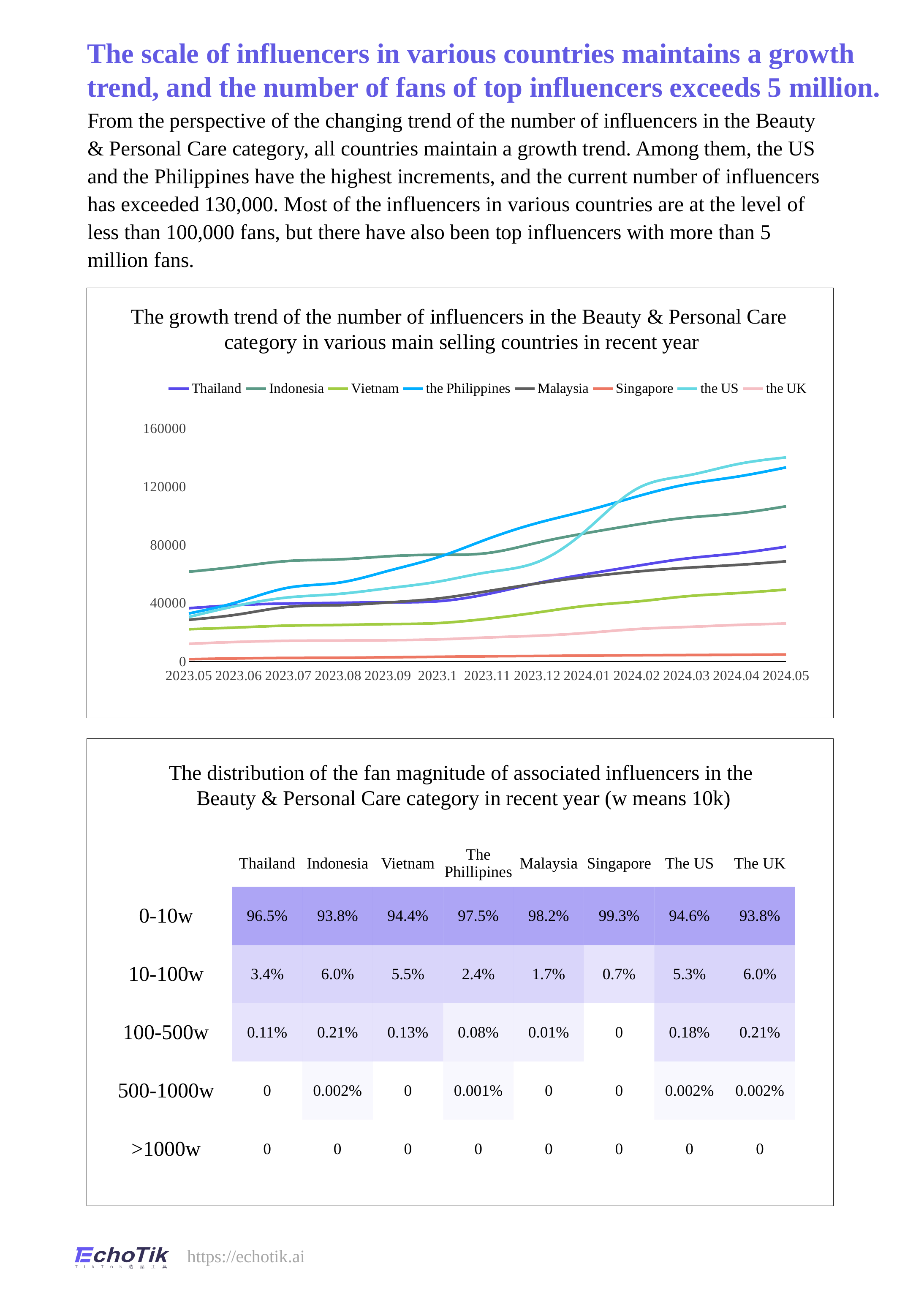
In the top line chart, is the value for the UK at 2024.05 greater or less than 40000? less What kind of chart is the top chart titled 'The growth trend of the number of influencers in the Beauty & Personal Care category in various main selling countries in recent year'? line chart In the top line chart, which country has the lowest number of influencers at 2024.05? Singapore In the top line chart, is the value for the US at 2024.05 greater or less than 120000? greater In the top line chart, is the value for Malaysia at 2024.05 greater or less than 80000? less In the top line chart, how many series does the legend list? 8 In the top line chart, how many time points are shown on the x axis? 13 In the bottom table on the distribution of fan magnitude, what is the share of Singapore influencers in the 0-10w band? 99.3% In the bottom table on the distribution of fan magnitude, what is the share of Indonesia influencers in the 10-100w band? 6.0% In the top line chart, which country has the highest number of influencers at 2024.05? the US In the top line chart, at 2024.05, which is larger: the value for the Philippines or the value for Indonesia? the Philippines In the top line chart, does the number of influencers for the US rise or fall from 2023.05 to 2024.05? rise